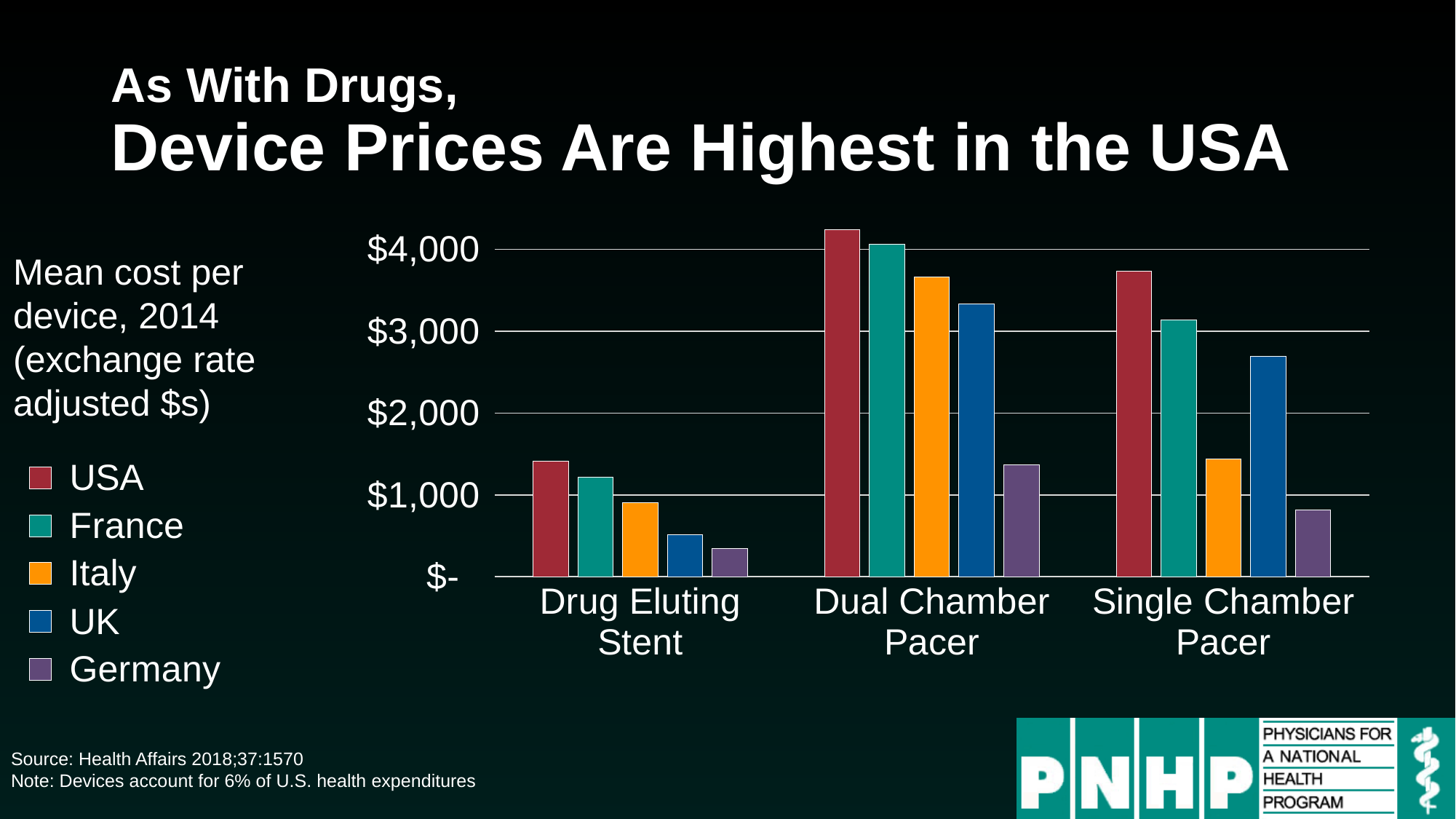
What colour represents the USA in the legend? red Which country has the lowest mean cost for the Drug Eluting Stent? Germany Is the USA value for the Dual Chamber Pacer greater or less than $4,000? greater How many countries does the legend list? 5 How many device categories are shown on the x axis? 3 Is the Germany value for the Drug Eluting Stent greater or less than $1,000? less What kind of chart is shown on the slide? bar chart Which country has the lowest mean cost for the Single Chamber Pacer? Germany For the Single Chamber Pacer, which is larger, the UK value or the Italy value? UK For the Dual Chamber Pacer, which is larger, the France value or the Germany value? France Which country has the highest mean cost for the Dual Chamber Pacer? USA Is the UK value for the Single Chamber Pacer greater or less than $2,000? greater